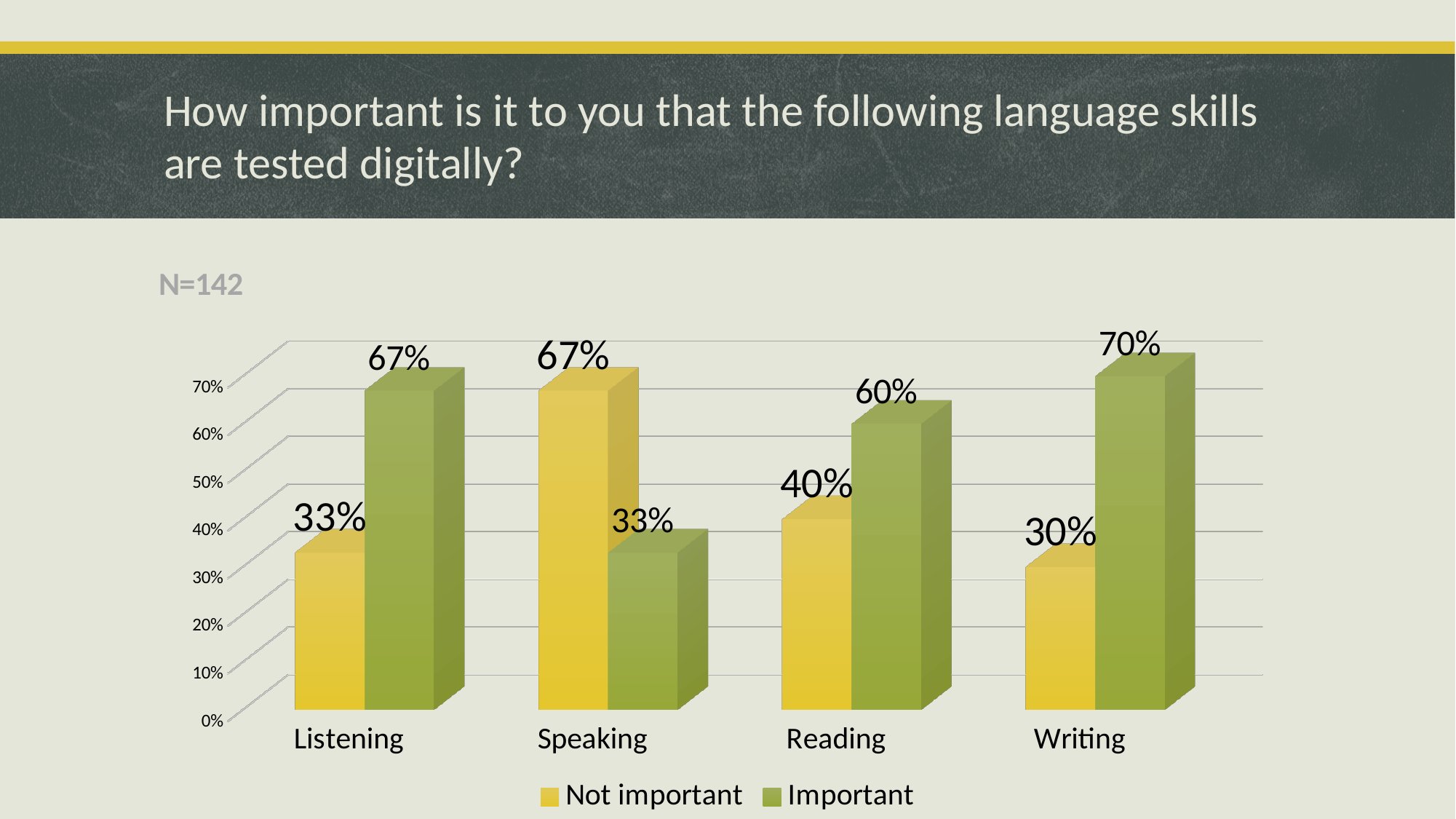
What is the value for Important for Listening? 67% How many categories are shown on the x axis? 4 Which is larger for Speaking: Not important or Important? Not important Which category has the lowest Not important value? Writing What is the difference between the Important and Not important values for Writing? 40% What is the value for Not important for Speaking? 67% Which category has the highest Important value? Writing What is the value for Important for Reading? 60% What kind of chart is shown on the slide? Bar chart How many series does the legend list? 2 What is the value for Not important for Writing? 30% What sample size is stated on the slide? N=142